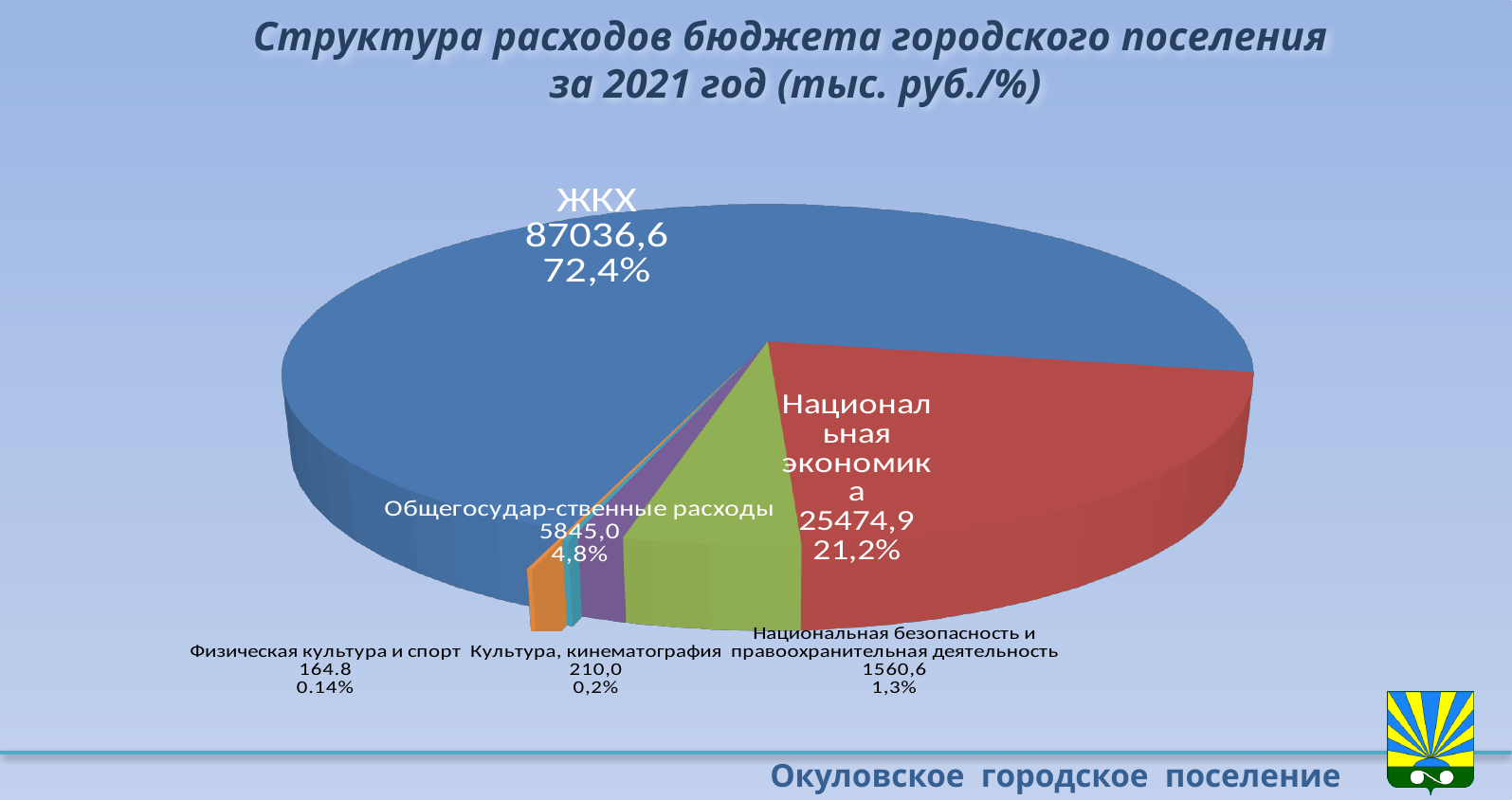
What is the difference between the values for ЖКХ and Национальная экономика? 61561,7 What is the value shown for Национальная экономика? 25474,9 Which category has the largest slice of the pie? ЖКХ What is the value shown for Культура, кинематография? 210,0 Which category has the smallest slice of the pie? Физическая культура и спорт What percentage share does Физическая культура и спорт have? 0.14% How many categories are shown in the pie chart? 6 What percentage share does ЖКХ have in the pie? 72,4% What is the value shown for Национальная безопасность и правоохранительная деятельность? 1560,6 What percentage share does Общегосударственные расходы have? 4,8% What is the value shown for ЖКХ? 87036,6 What kind of chart is shown on the slide? pie chart